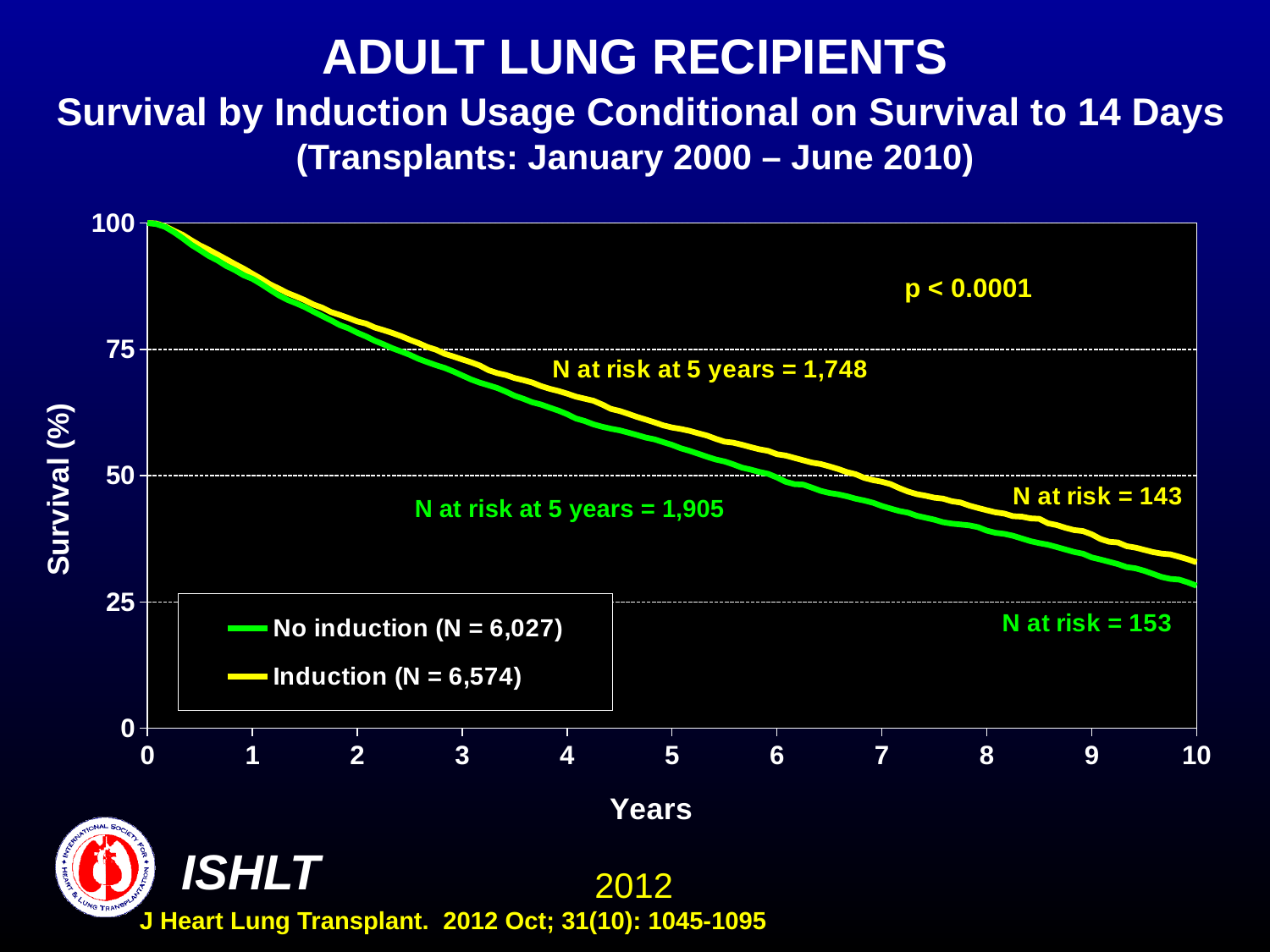
Is the survival for the Induction group at 10 years greater or less than 50%? less What kind of chart is shown on the slide? line chart What is the sample size (N) of the Induction group shown in the legend? 6,574 What p-value is shown on the chart? p < 0.0001 What is the N at risk at 5 years for the Induction group? 1,748 What is the N at risk at 5 years for the No induction group? 1,905 What is the sample size (N) of the No induction group shown in the legend? 6,027 What is the N at risk at the end of follow-up for the No induction group? 153 How many series does the legend list? 2 Do the survival curves rise or fall as years increase? fall Which group has higher survival at 5 years, Induction or No induction? Induction What is the N at risk at the end of follow-up for the Induction group? 143